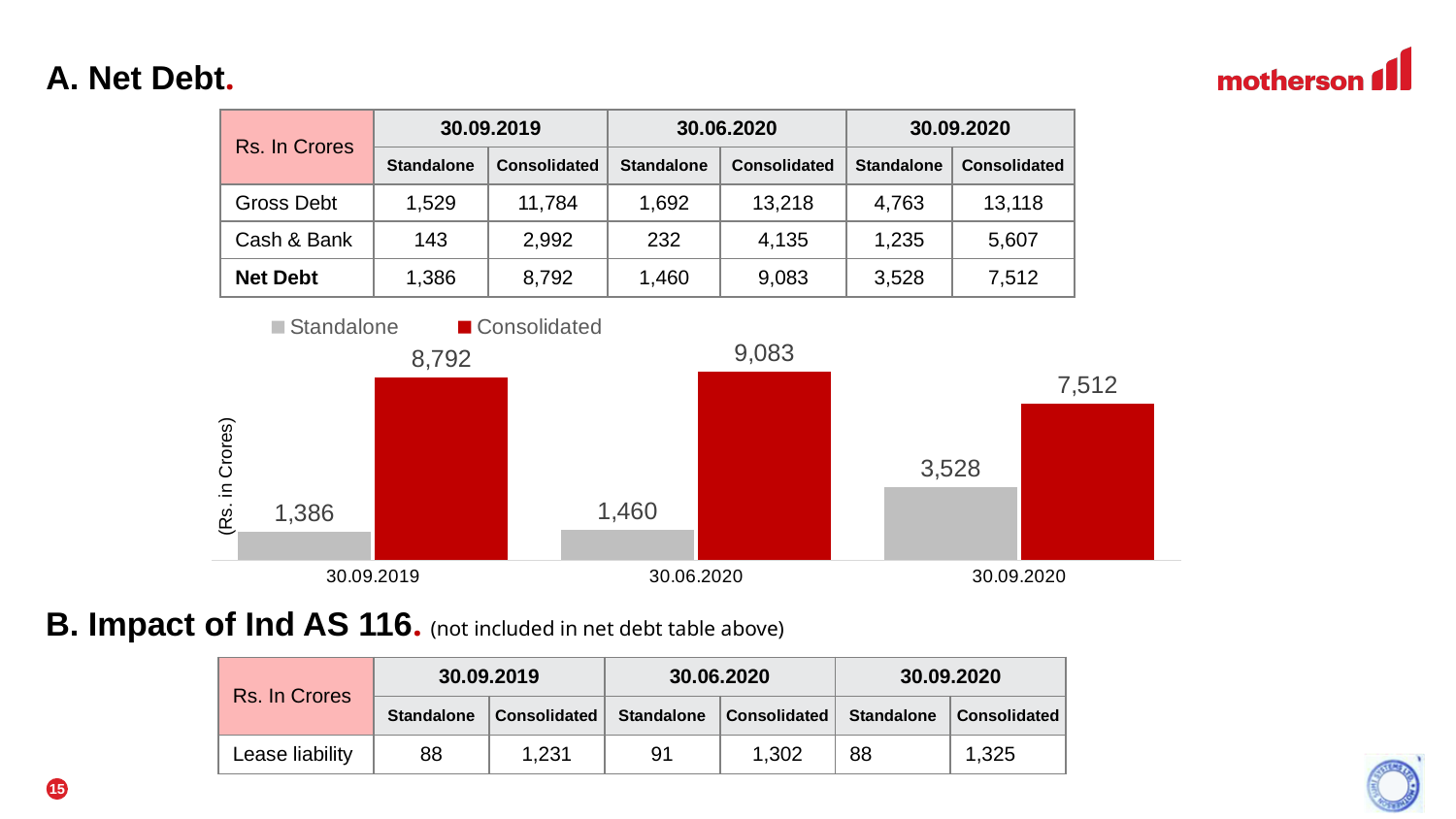
How many series does the chart legend list? 2 What is the Consolidated net debt value shown for 30.06.2020 in the chart? 9,083 Which date has the highest Consolidated value in the chart? 30.06.2020 Which is larger in the chart: the Consolidated value for 30.09.2019 or the Consolidated value for 30.09.2020? 30.09.2019 What is the Standalone value shown for 30.09.2019 in the chart? 1,386 Which date has the lowest Standalone value in the chart? 30.09.2019 What is the difference between the Consolidated and Standalone values for 30.09.2020 in the chart? 3,984 What is the Standalone net debt value shown for 30.09.2020 in the chart? 3,528 How many dates are shown on the x axis of the chart? 3 What is the y-axis label of the chart? (Rs. in Crores) What kind of chart is shown on the slide? bar chart Do the Standalone values rise or fall from 30.09.2019 to 30.09.2020 in the chart? rise